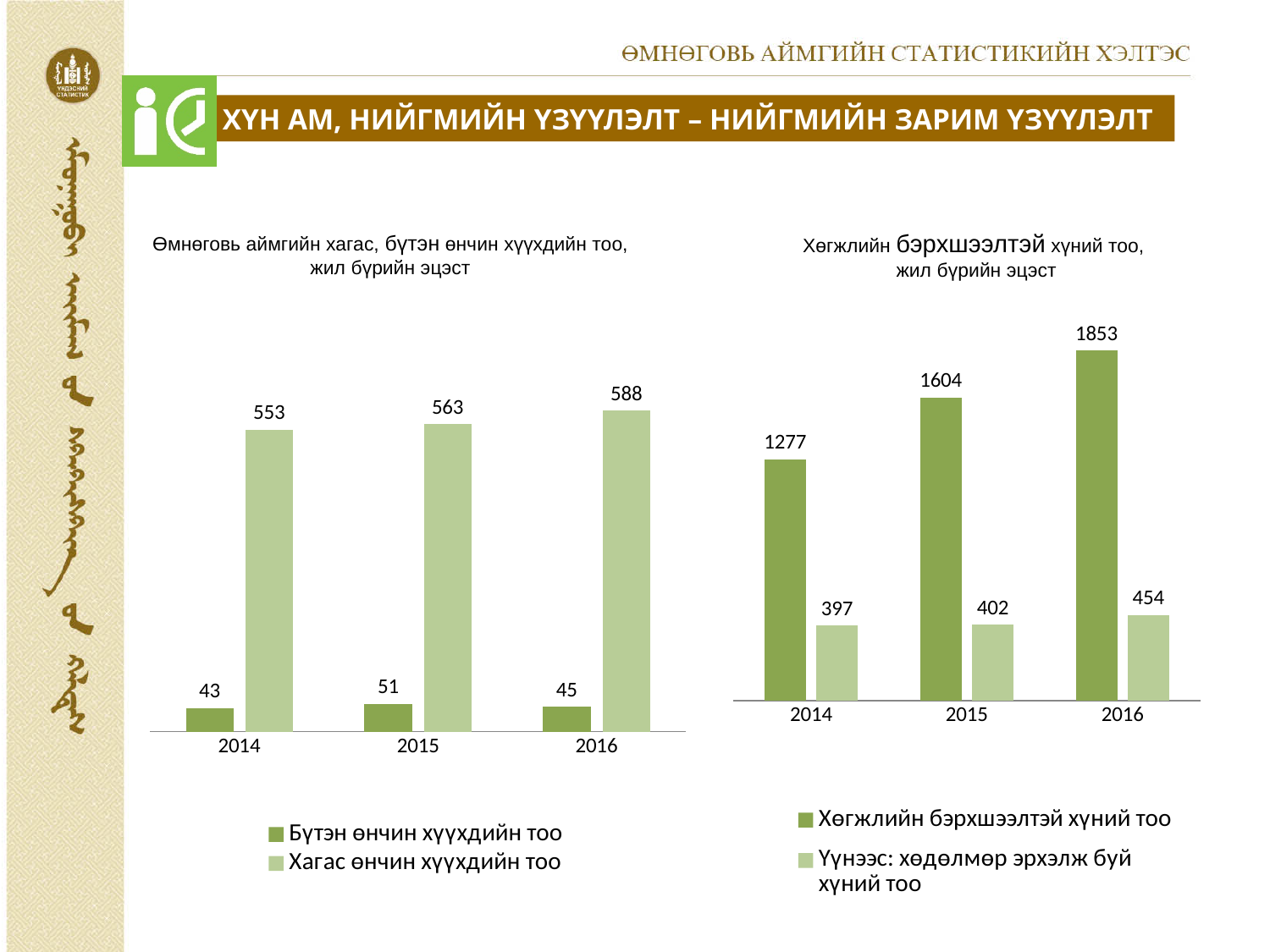
In the left chart (Өмнөговь аймгийн хагас, бүтэн өнчин хүүхдийн тоо), what is the value for Хагас өнчин хүүхдийн тоо in 2016? 588 In the right chart, does the value for Хөгжлийн бэрхшээлтэй хүний тоо rise or fall from 2014 to 2016? rise In the right chart, what is the difference between Хөгжлийн бэрхшээлтэй хүний тоо and Үүнээс: хөдөлмөр эрхэлж буй хүний тоо in 2014? 880 In the left chart, what is the value for Бүтэн өнчин хүүхдийн тоо in 2015? 51 In the left chart, which year has the lowest value for Хагас өнчин хүүхдийн тоо? 2014 In the right chart, which is larger: Үүнээс: хөдөлмөр эрхэлж буй хүний тоо in 2015 or in 2016? 2016 In the right chart, what is the value for Үүнээс: хөдөлмөр эрхэлж буй хүний тоо in 2016? 454 In the right chart (Хөгжлийн бэрхшээлтэй хүний тоо), what is the value for Хөгжлийн бэрхшээлтэй хүний тоо in 2015? 1604 In the left chart, how many series does the legend list? 2 In the left chart, which year has the highest value for Бүтэн өнчин хүүхдийн тоо? 2015 In the left chart, what is the difference between Хагас өнчин хүүхдийн тоо in 2016 and in 2014? 35 What type of chart is the right chart? bar chart